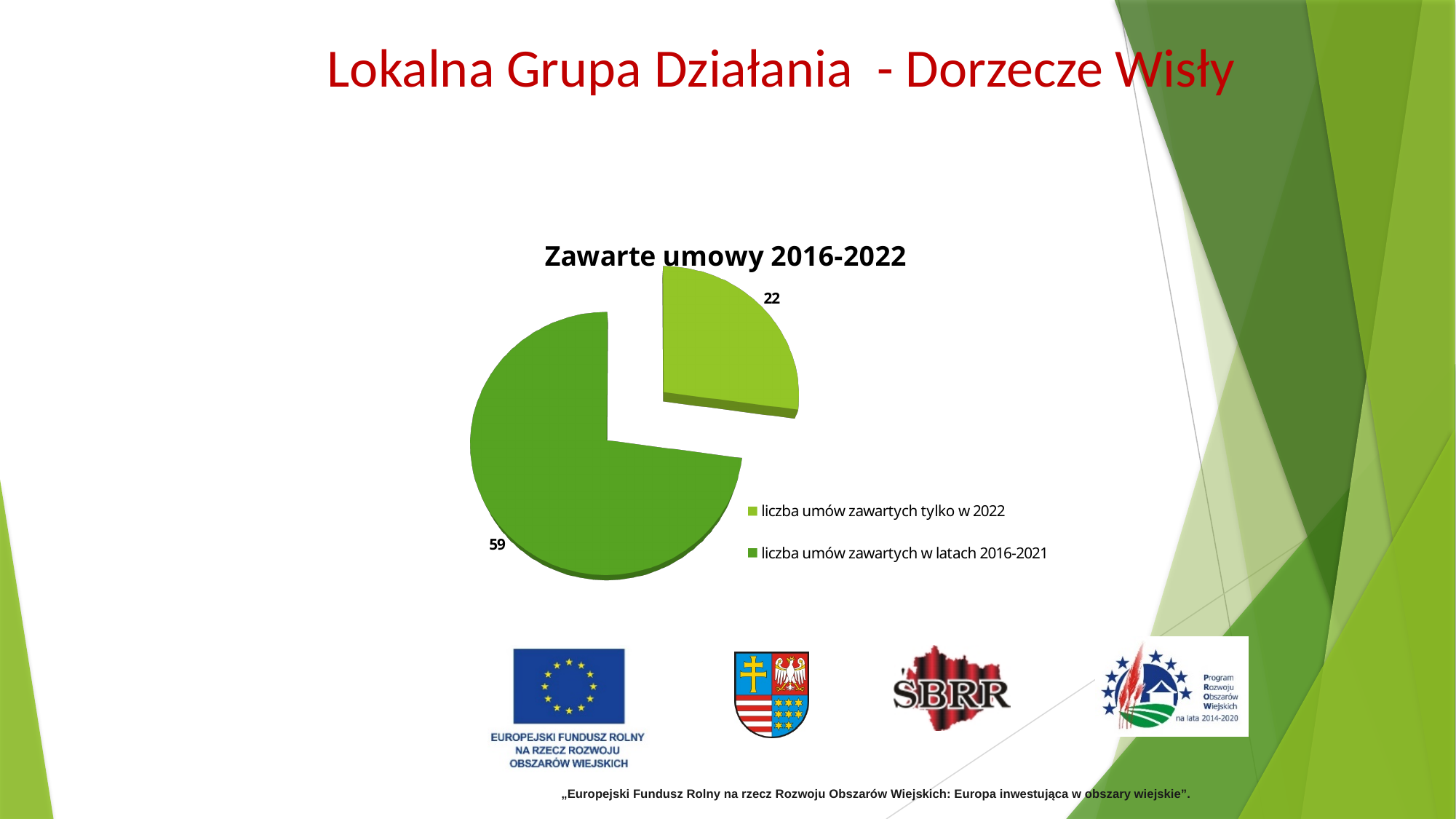
What share of the pie does "liczba umów zawartych tylko w 2022" represent? 27.2% What is the value for "liczba umów zawartych tylko w 2022"? 22 Which slice of the pie is the largest? liczba umów zawartych w latach 2016-2021 Which is larger: the number of contracts concluded only in 2022 or the number concluded in 2016-2021? liczba umów zawartych w latach 2016-2021 How many entries does the legend list? 2 What is the title of the chart? Zawarte umowy 2016-2022 What is the difference between the number of contracts concluded in 2016-2021 and those concluded only in 2022? 37 What is the value for "liczba umów zawartych w latach 2016-2021"? 59 Which slice of the pie is the smallest? liczba umów zawartych tylko w 2022 What type of chart is shown on the slide? pie chart What is the total of all slices in the pie chart? 81 How many slices does the pie chart have? 2